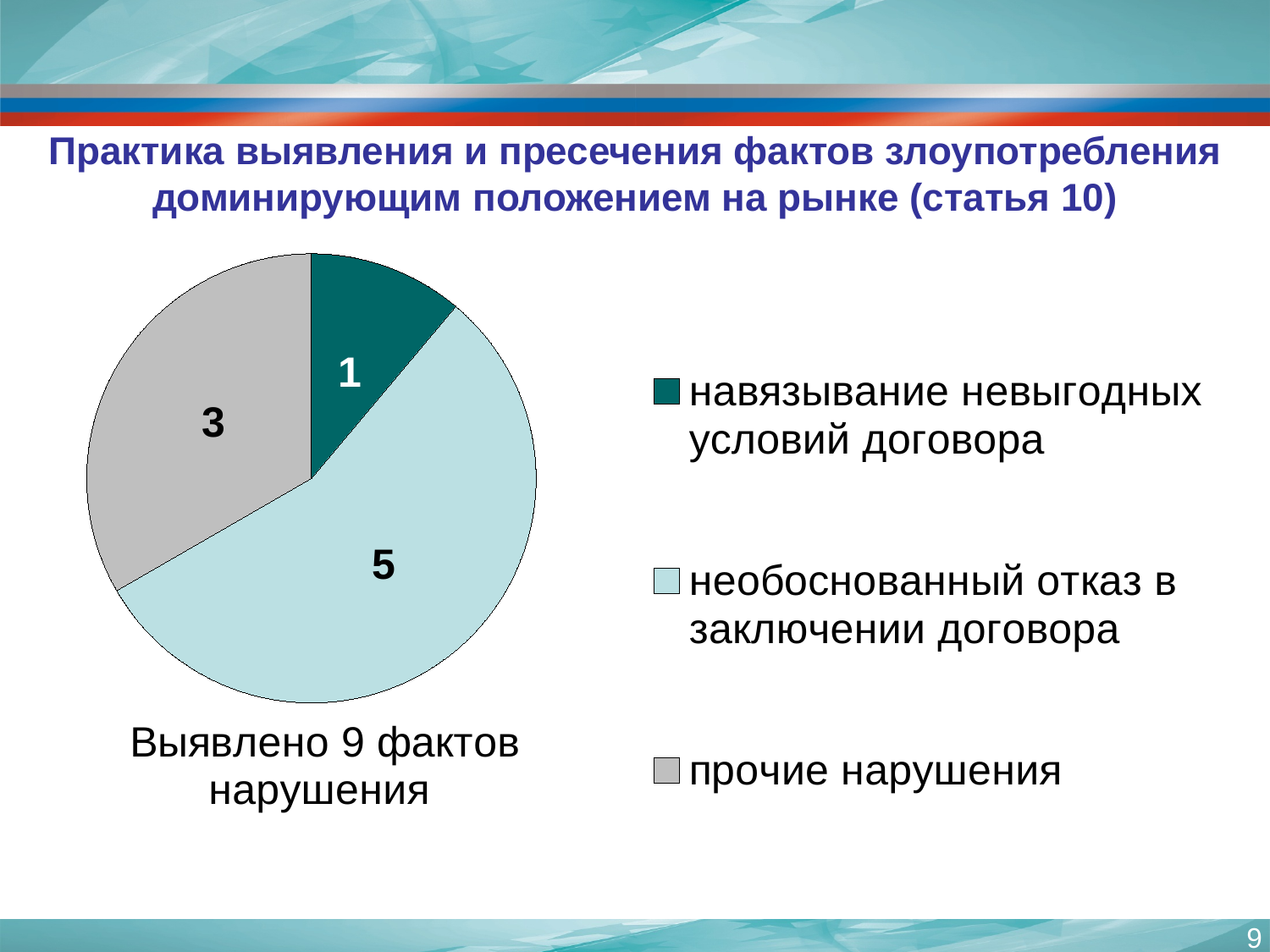
What is the value for «навязывание невыгодных условий договора»? 1 How many entries does the legend list? 3 Which category has the largest slice? необоснованный отказ в заключении договора What is the total of all slices in the pie chart? 9 Which is larger: «прочие нарушения» or «навязывание невыгодных условий договора»? прочие нарушения What is the difference between the values for «необоснованный отказ в заключении договора» and «прочие нарушения»? 2 What colour is the slice for «прочие нарушения»? grey What is the value for «необоснованный отказ в заключении договора»? 5 How many slices does the pie chart have? 3 What kind of chart is shown on the slide? pie chart Which category has the smallest slice? навязывание невыгодных условий договора What is the value for «прочие нарушения»? 3